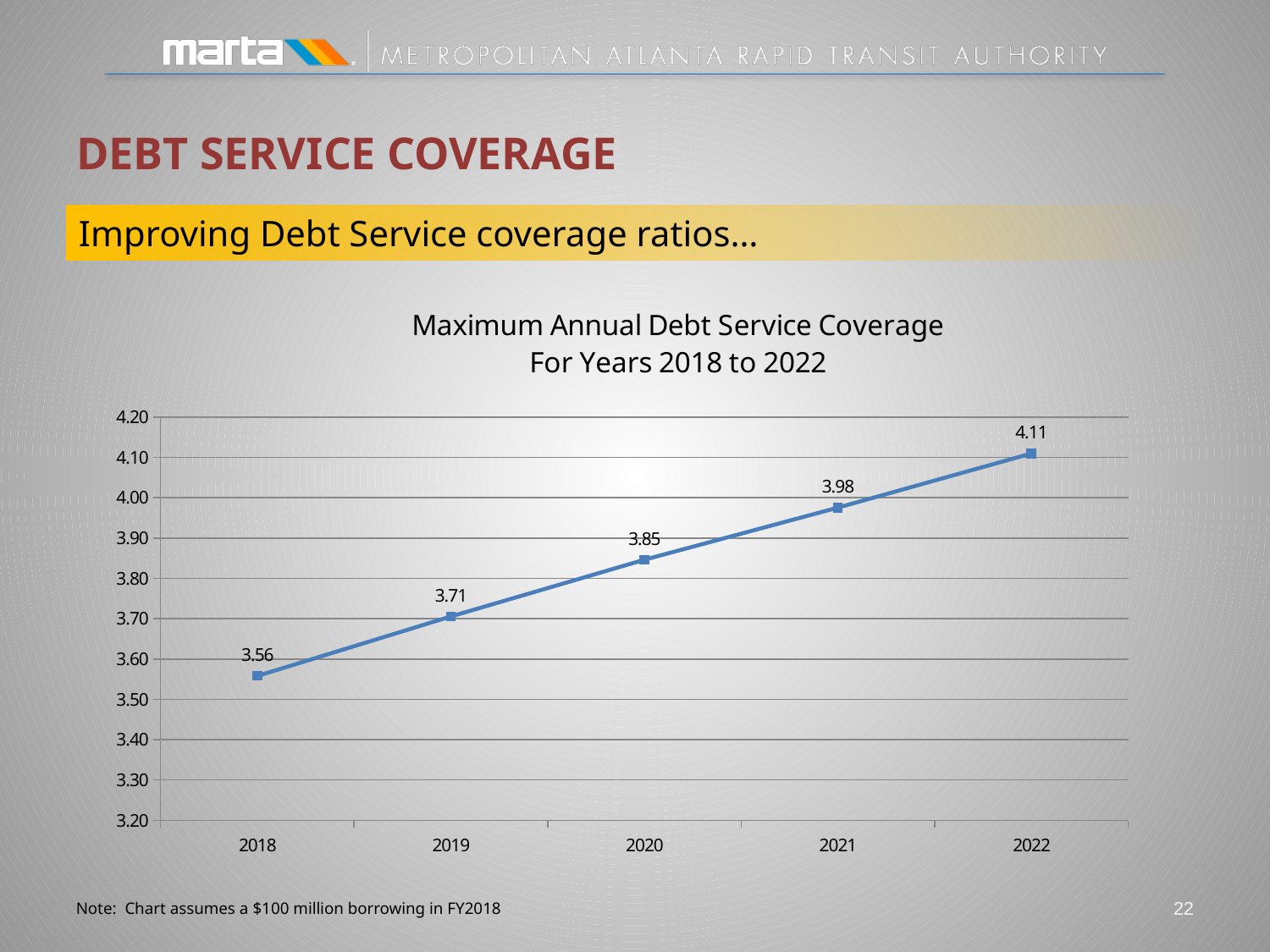
What kind of chart is shown on the slide? line chart How many years are plotted on the chart? 5 Which year has the highest debt service coverage? 2022 What is the difference between the coverage values for 2021 and 2019? 0.27 Do the coverage values rise or fall from 2018 to 2022? rise Is the value for 2021 greater or less than 4.00? less Which year has the lowest debt service coverage? 2018 Which year has a higher coverage value, 2019 or 2021? 2021 What is the maximum annual debt service coverage for 2020? 3.85 What is the difference between the coverage values for 2022 and 2018? 0.55 What is the maximum annual debt service coverage for 2018? 3.56 What is the maximum annual debt service coverage for 2022? 4.11